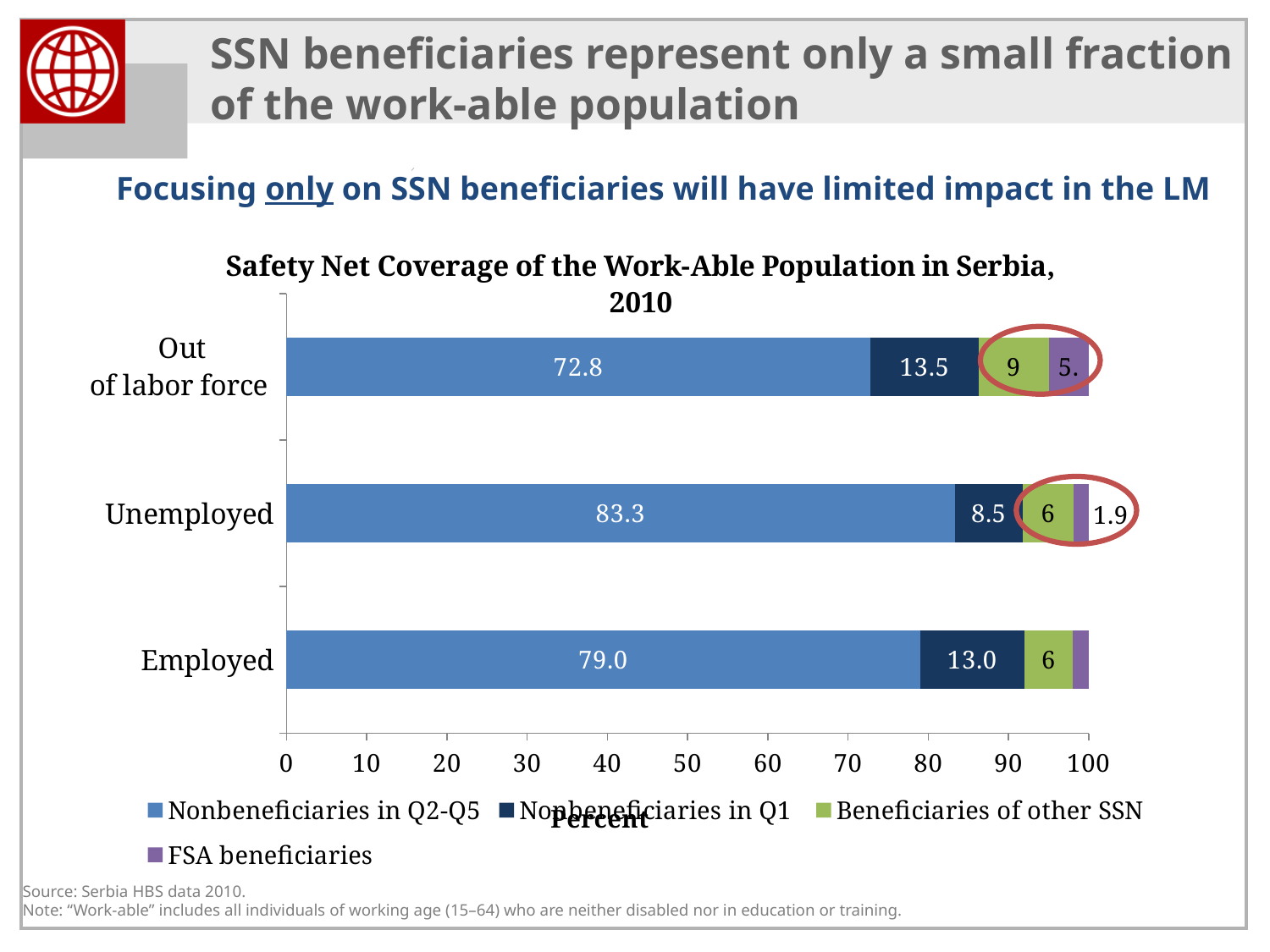
How many series does the legend list? 4 Which category has the highest value for Nonbeneficiaries in Q2-Q5? Unemployed Which category has the lowest value for Nonbeneficiaries in Q1? Unemployed What is the title of the chart? Safety Net Coverage of the Work-Able Population in Serbia, 2010 What is the value for Beneficiaries of other SSN among the Employed? 6 What is the value for Nonbeneficiaries in Q1 among those Out of labor force? 13.5 How many categories are shown on the y axis? 3 What is the difference between the Nonbeneficiaries in Q2-Q5 values for Unemployed and Out of labor force? 10.5 What is the value for FSA beneficiaries among the Unemployed? 1.9 What is the value for Nonbeneficiaries in Q2-Q5 among the Unemployed? 83.3 What kind of chart is shown on the slide? Stacked bar chart Which is larger: Nonbeneficiaries in Q1 for Out of labor force or for Employed? Out of labor force